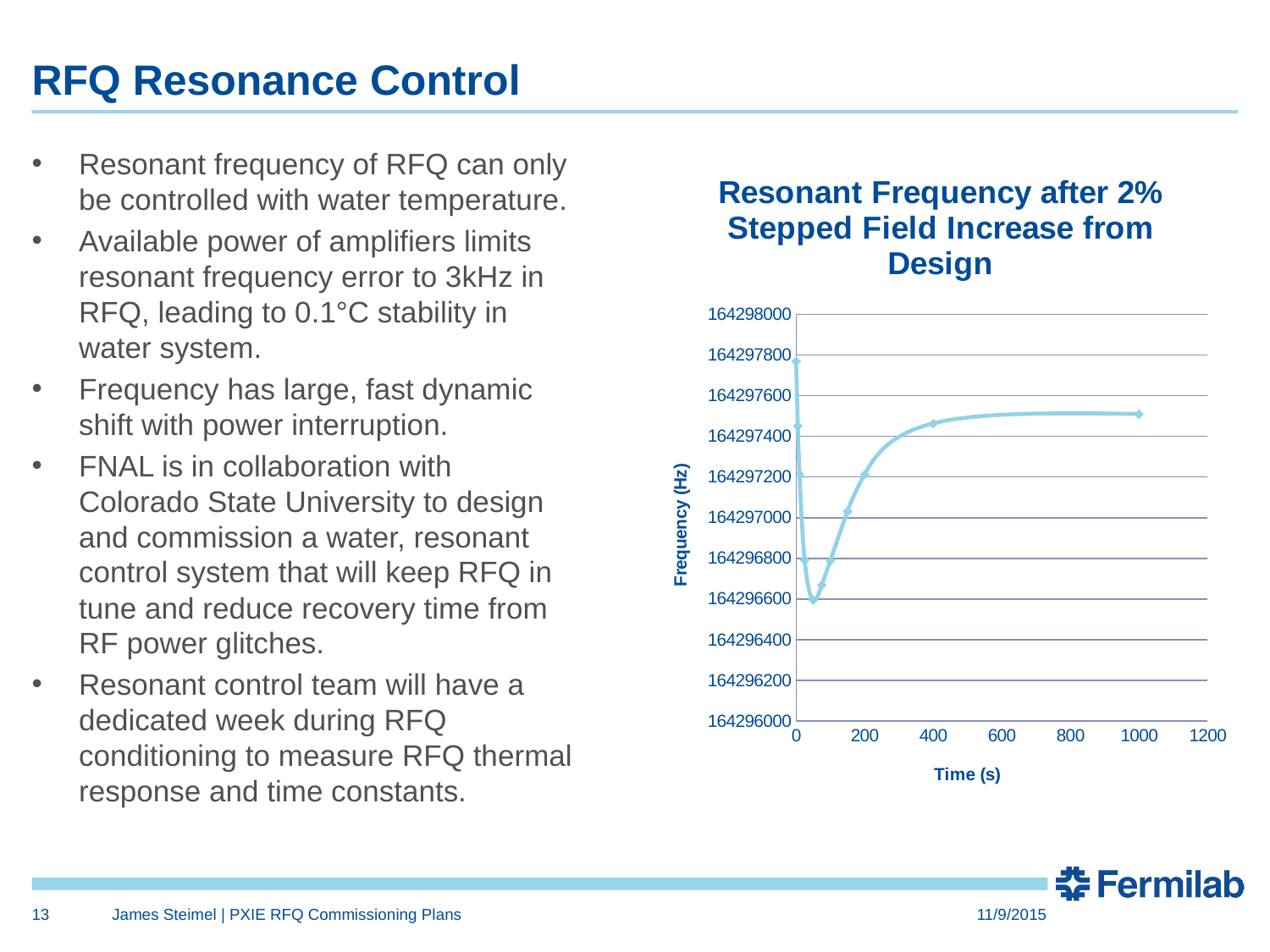
Is the lowest frequency value on the chart greater or less than 164296800? less How many data series are plotted on the chart? 1 What is the title of the chart? Resonant Frequency after 2% Stepped Field Increase from Design What is the highest value shown on the x axis? 1200 What kind of chart is shown on the slide? line chart Is the value at time 400 s greater or less than 164297200? greater Is the first value at time 0 s greater or less than 164297600? greater After reaching its minimum, does the frequency rise or fall as time increases toward 1000 s? rise What is the label of the x axis of the chart? Time (s) Which is larger, the frequency at time 1000 s or the lowest frequency reached near time 60 s? the frequency at time 1000 s